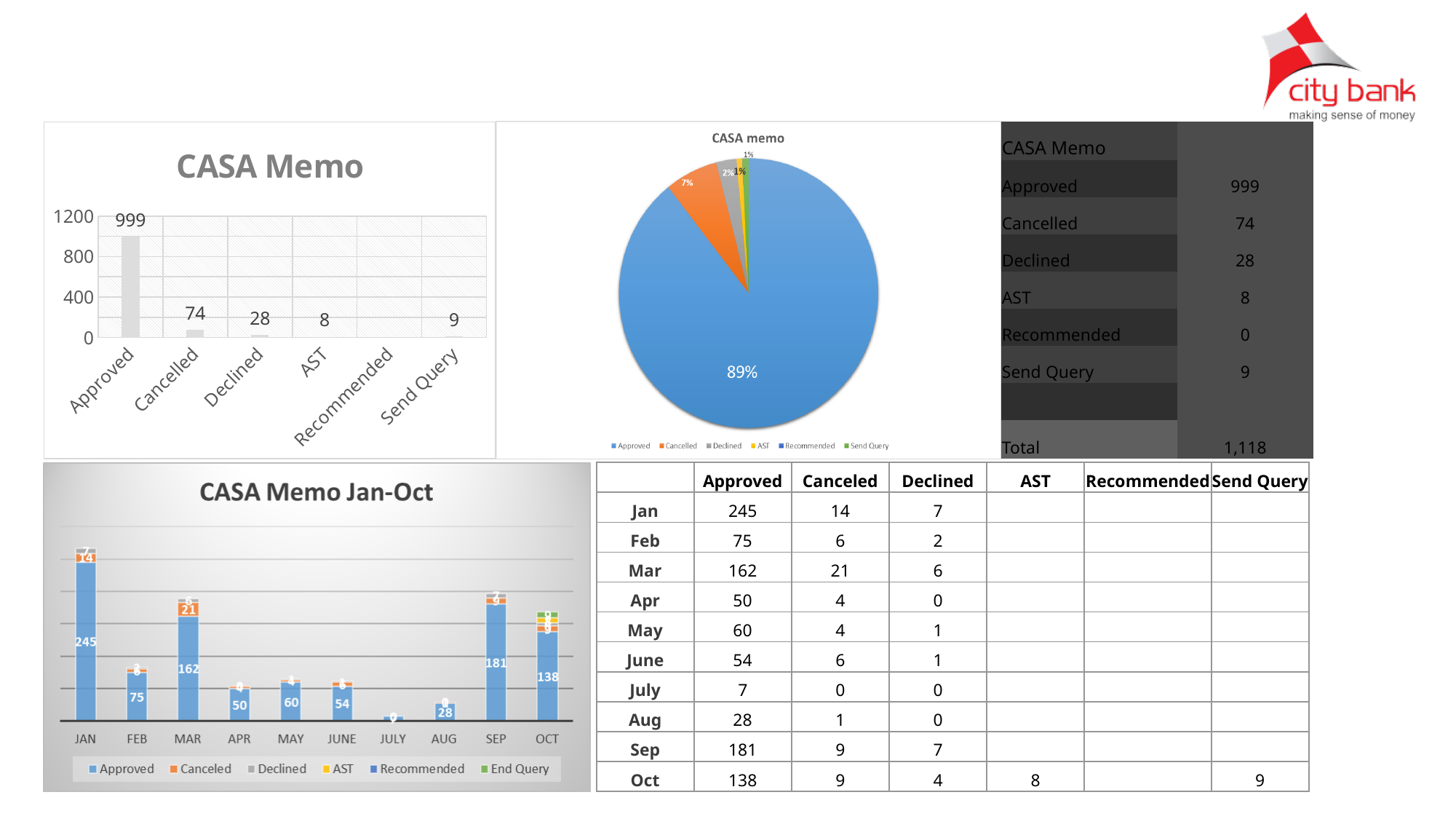
In the CASA Memo Jan-Oct chart, what is the Approved value for SEP? 181 In the CASA Memo bar chart at the top left, which category has the highest value? Approved In the CASA Memo bar chart at the top left, what is the value for Cancelled? 74 What kind of chart is the CASA Memo chart at the top left of the slide? Bar chart How many categories are shown on the x axis of the CASA Memo bar chart at the top left? 6 How many months are shown on the x axis of the CASA Memo Jan-Oct chart? 10 In the CASA Memo bar chart at the top left, what is the value for Approved? 999 In the CASA memo pie chart, what share does the Approved slice have? 89% How many entries does the legend of the CASA memo pie chart list? 6 In the CASA Memo bar chart at the top left, what is the difference between the Cancelled and Declined values? 46 In the CASA memo pie chart, what share does the Cancelled slice have? 7% In the CASA Memo Jan-Oct chart, which month has the larger Approved value, MAR or OCT? MAR